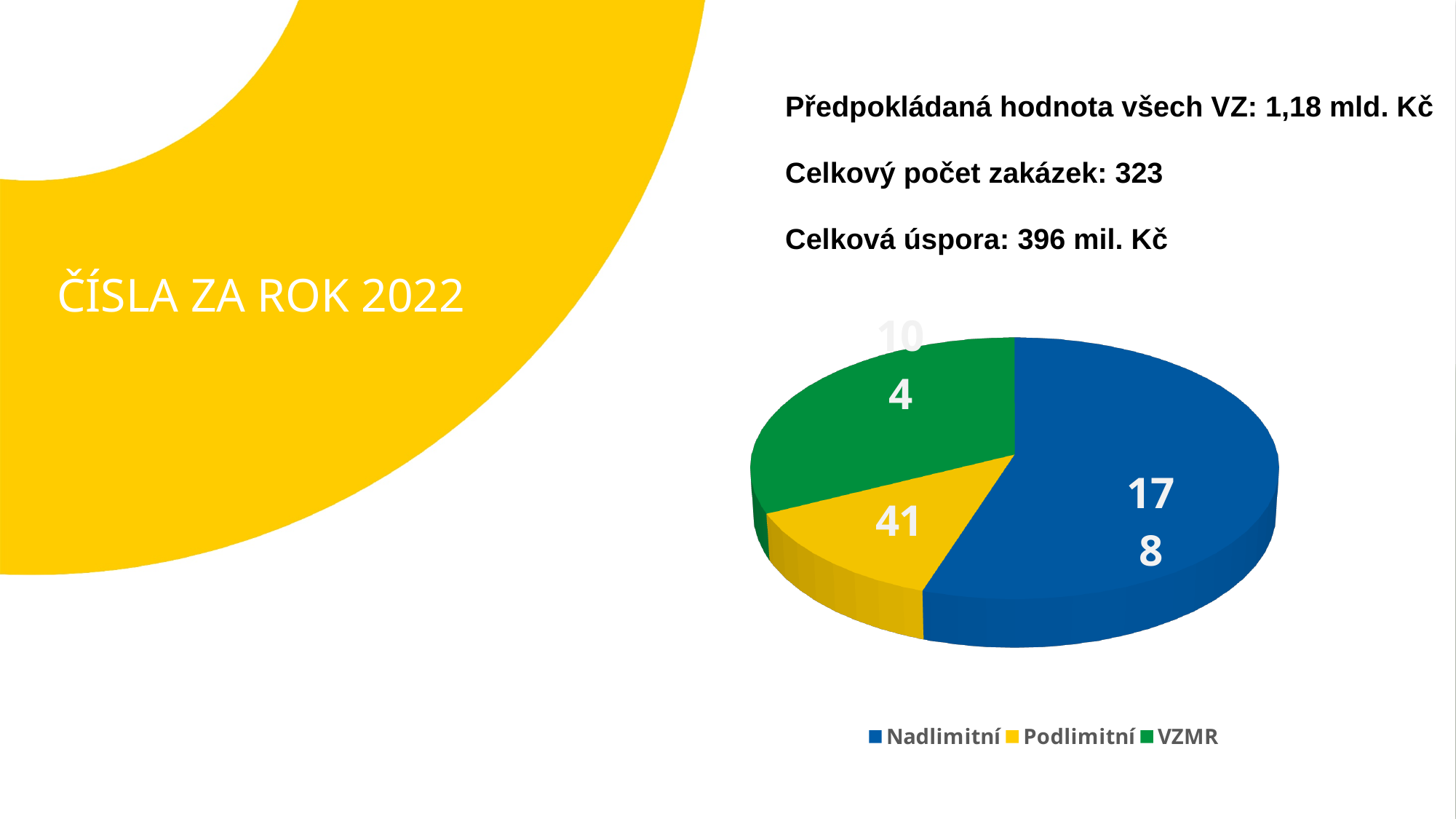
What is the difference between the values for VZMR and Podlimitní? 63 Which category has the largest slice in the pie chart? Nadlimitní What is the difference between the values for Nadlimitní and Podlimitní? 137 What is the value for VZMR in the pie chart? 104 What is the value for Nadlimitní in the pie chart? 178 What is the value for Podlimitní in the pie chart? 41 What type of chart is shown on the slide? Pie chart Which category has the smallest slice in the pie chart? Podlimitní What colour is the Podlimitní slice in the pie chart? Yellow What is the total of all slices in the pie chart? 323 How many series does the legend of the pie chart list? 3 Which is larger, the value for VZMR or the value for Podlimitní? VZMR